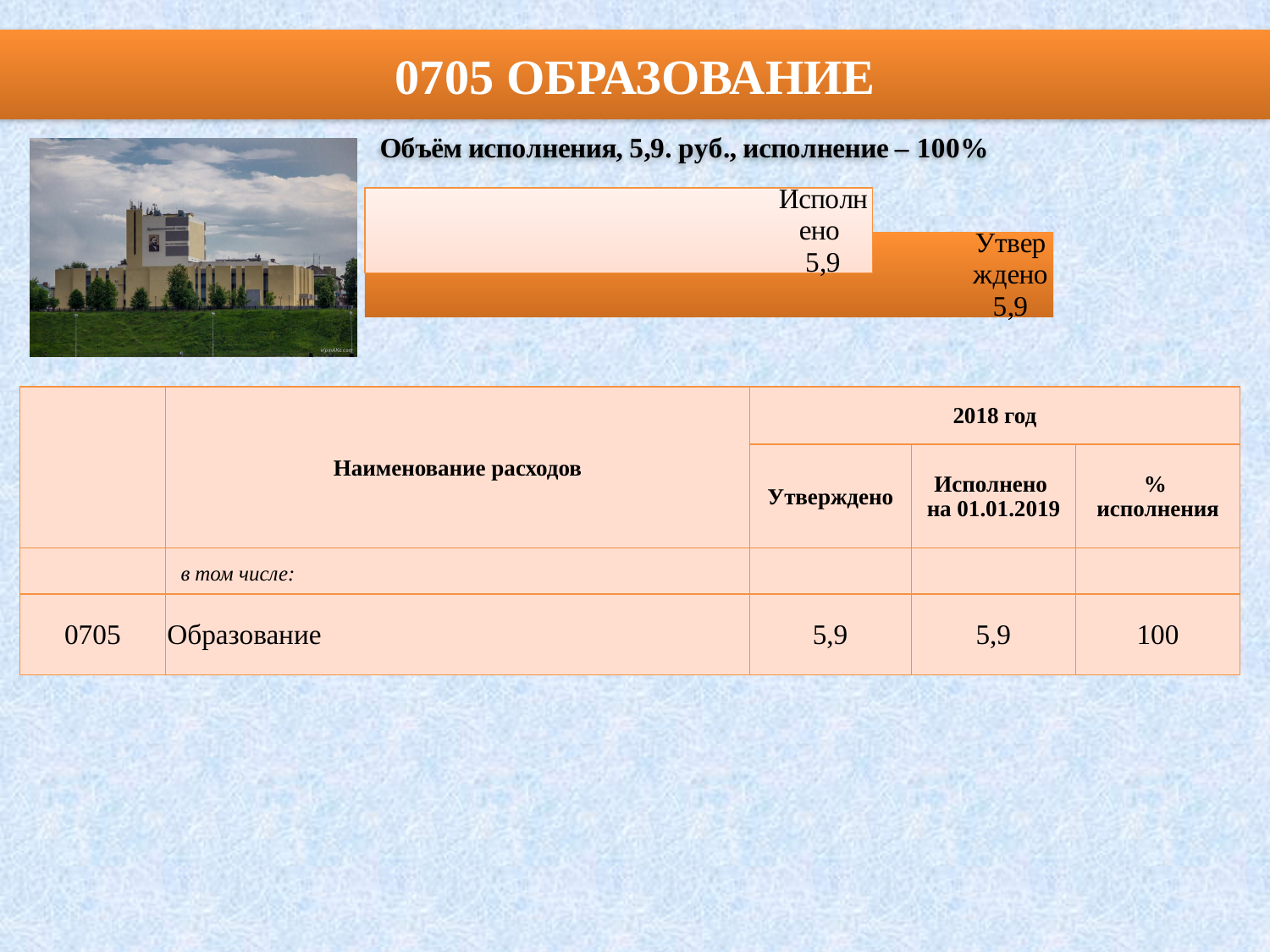
What kind of chart is shown on the slide? bar chart What value is shown for the Утверждено bar in the chart? 5,9 What is the difference between the Утверждено value and the Исполнено value in the chart? 0 What value is shown for the Исполнено bar in the chart? 5,9 Which bar in the chart is coloured dark orange? Утверждено Is the Утверждено value in the chart larger than, smaller than, or equal to the Исполнено value? equal What is the title shown in the header band above the chart? 0705 ОБРАЗОВАНИЕ How many bars does the chart contain? 2